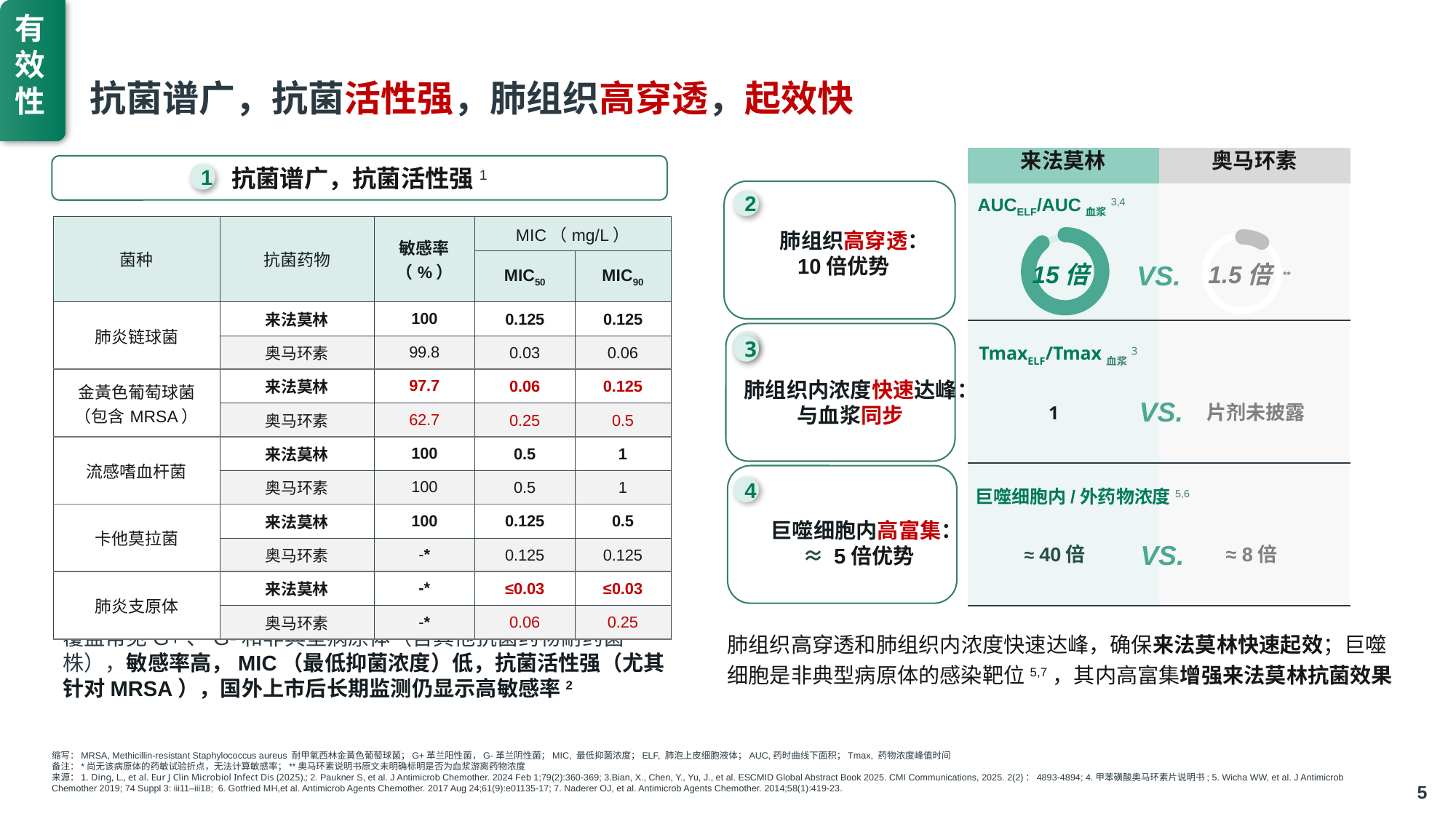
In the AUC_ELF/AUC_血浆 ring charts, which drug has the smaller value? 奥马环素 How many ring charts are shown in the AUC_ELF/AUC_血浆 row? 2 In the AUC_ELF/AUC_血浆 comparison, what value is shown in the ring chart for 来法莫林? 15 倍 In the AUC_ELF/AUC_血浆 comparison, what value is shown in the ring chart for 奥马环素? 1.5 倍 What kind of chart is used to show the AUC_ELF/AUC_血浆 values for the two drugs? Ring (donut) chart Is the 来法莫林 value in the AUC_ELF/AUC_血浆 ring chart greater or less than 10 倍? greater Which metric do the two ring charts on the right side of the slide illustrate? AUC_ELF/AUC_血浆 What colour is the ring chart for 来法莫林 in the AUC_ELF/AUC_血浆 row? Green In the AUC_ELF/AUC_血浆 ring charts, which drug has the larger value, 来法莫林 or 奥马环素? 来法莫林 What is the difference between the 来法莫林 and 奥马环素 values shown in the AUC_ELF/AUC_血浆 ring charts? 13.5 倍